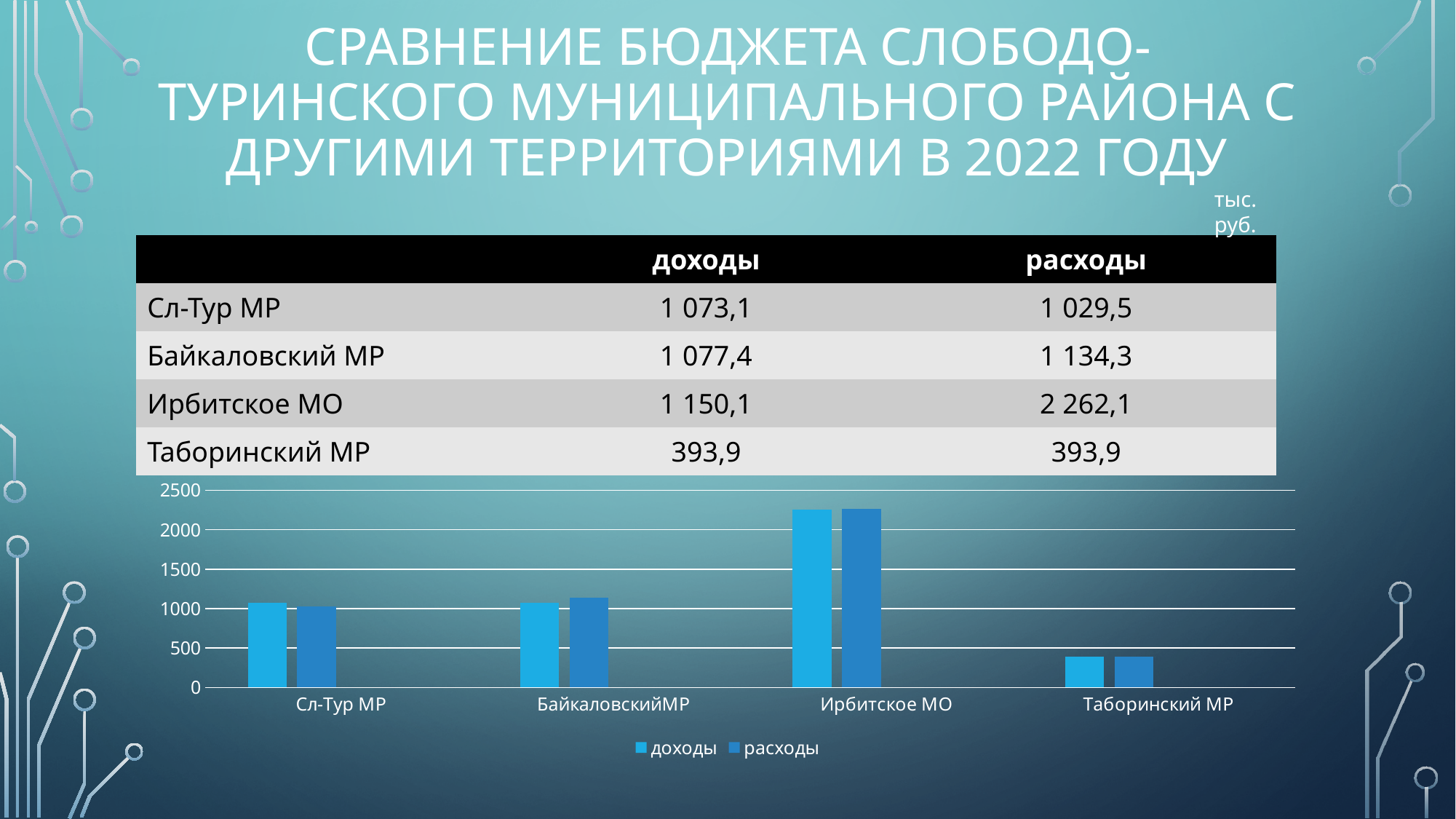
What are the two entries in the chart legend? доходы, расходы How many series does the chart legend list? 2 What is the difference between расходы and доходы for Байкаловский МР? 56,9 How many territories (categories) are plotted on the x axis of the chart? 4 Is the доходы value for Таборинский МР greater or less than 500? less For Байкаловский МР, which is larger: доходы or расходы? расходы Which territory has the lowest доходы in the chart? Таборинский МР What type of chart is shown on the slide? bar chart What is the доходы value for Сл-Тур МР? 1 073,1 Is the доходы value for Сл-Тур МР greater or less than 1000? greater Which territory has the highest расходы in the chart? Ирбитское МО Is the расходы value for Ирбитское МО greater or less than 2000? greater